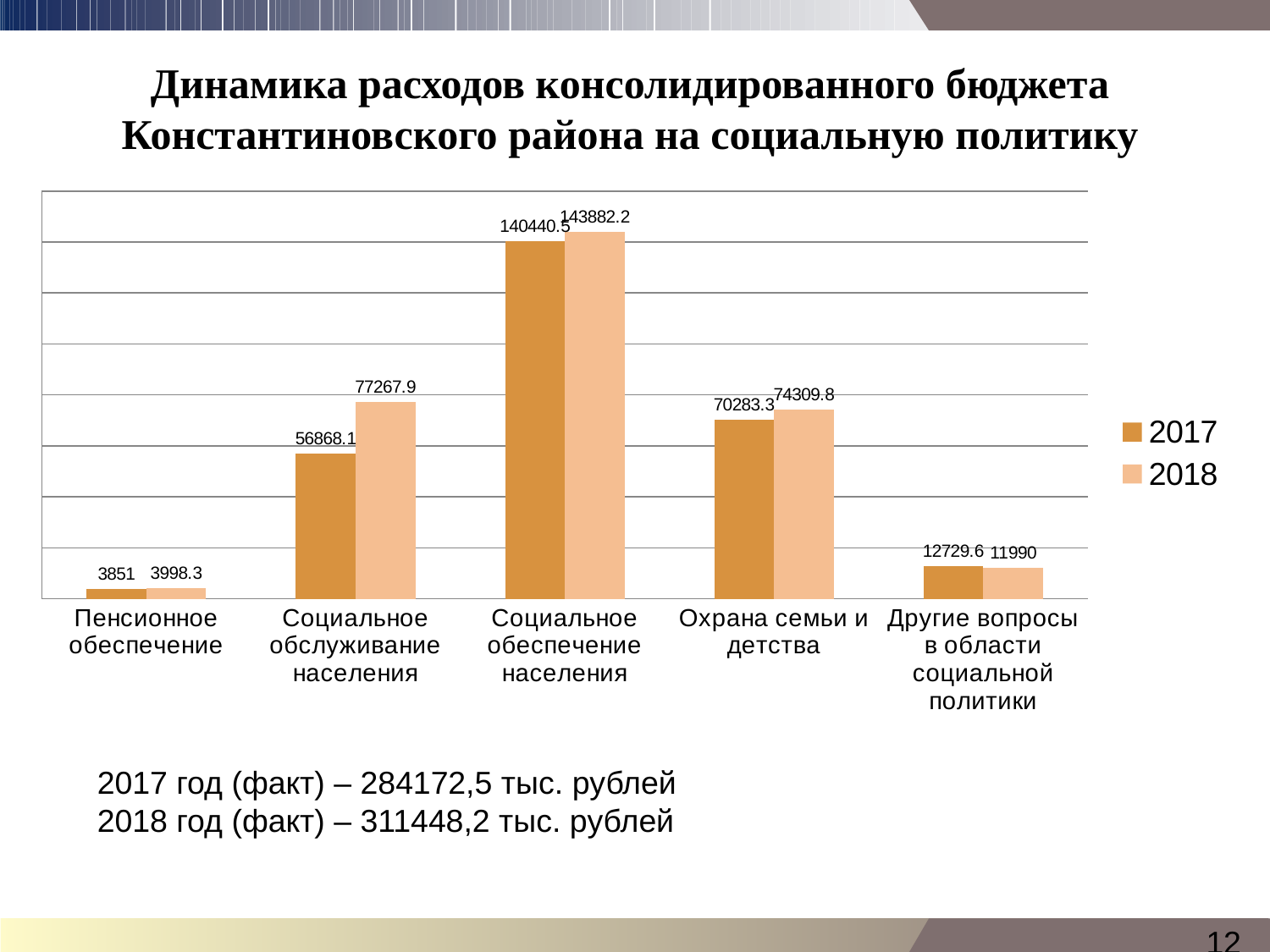
What is the 2017 value for Другие вопросы в области социальной политики? 12729.6 What type of chart is shown on the slide? Bar chart What is the difference between the 2018 and 2017 values for Социальное обслуживание населения? 20399.8 For Другие вопросы в области социальной политики, which year has the larger value, 2017 or 2018? 2017 How many categories are shown on the x axis? 5 What is the 2018 value for Охрана семьи и детства? 74309.8 Which series is shown in the darker orange colour? 2017 Which category has the highest 2018 value? Социальное обеспечение населения What is the 2017 value for Социальное обслуживание населения? 56868.1 Which category has the lowest 2017 value? Пенсионное обеспечение What is the 2018 value for Пенсионное обеспечение? 3998.3 How many series does the legend list? 2